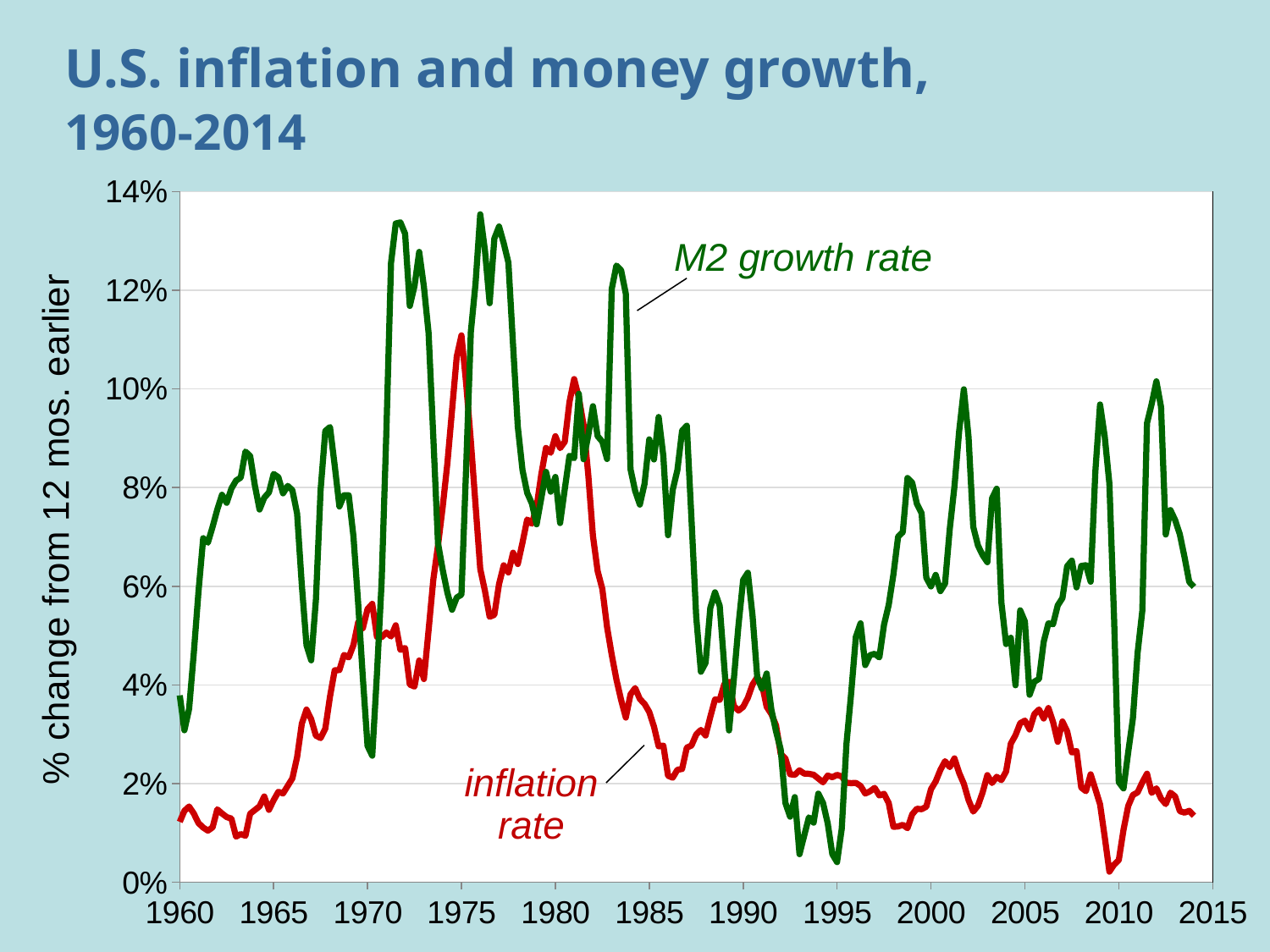
Does the inflation rate rise or fall between 1980 and 1985? fall Which series reaches the highest value anywhere on the chart? M2 growth rate How many data series are plotted on the chart? 2 Is the M2 growth rate around 1995 greater or less than 2%? less What kind of chart is shown on the slide? line chart Is the M2 growth rate around 1972 greater or less than 12%? greater Around 2012, which series has the higher value, the inflation rate or the M2 growth rate? M2 growth rate What is the label on the vertical axis of the chart? % change from 12 mos. earlier Is the inflation rate in 1960 greater or less than 2%? less Around 1975, which series has the higher value, the inflation rate or the M2 growth rate? inflation rate What is the title of the chart on the slide? U.S. inflation and money growth, 1960-2014